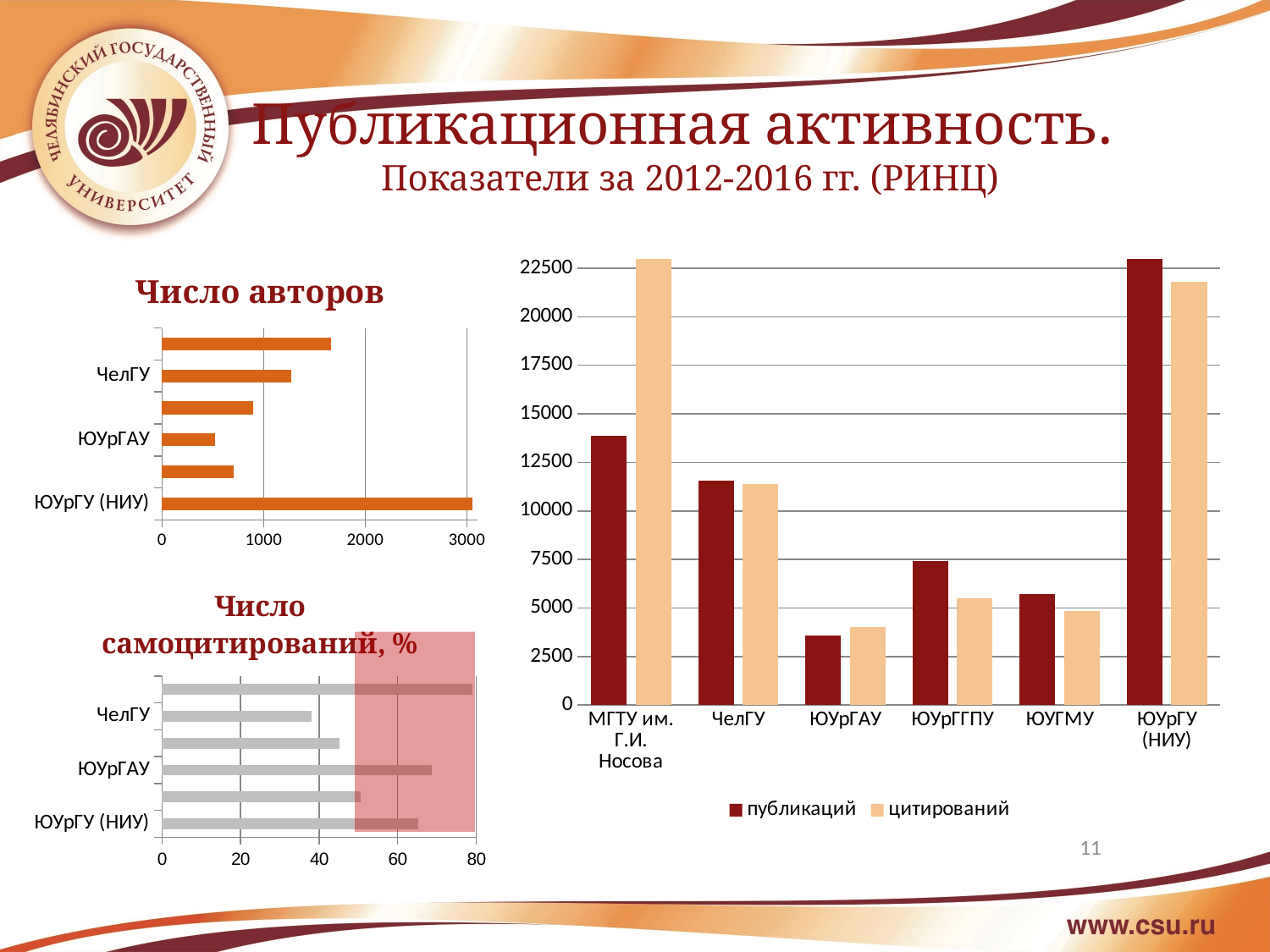
On the large chart on the right, which category has the lowest value for публикаций? ЮУрГАУ On the large chart on the right, is the цитирований value for ЧелГУ greater or less than 12500? less How many series does the legend of the large chart on the right list? 2 In the chart titled 'Число авторов', which labelled category has the highest value? ЮУрГУ (НИУ) What kind of chart is the chart titled 'Число самоцитирований, %'? bar chart On the large chart on the right, which category has the lowest value for цитирований? ЮУрГАУ On the large chart on the right, is the публикаций value for МГТУ им. Г.И. Носова greater or less than 12500? greater In the chart titled 'Число самоцитирований, %', is the value for ЮУрГАУ greater or less than 60? greater On the large chart on the right, for МГТУ им. Г.И. Носова, which is larger: публикаций or цитирований? цитирований On the large chart on the right, which category has the highest value for публикаций? ЮУрГУ (НИУ) How many categories are shown on the x axis of the large chart on the right? 6